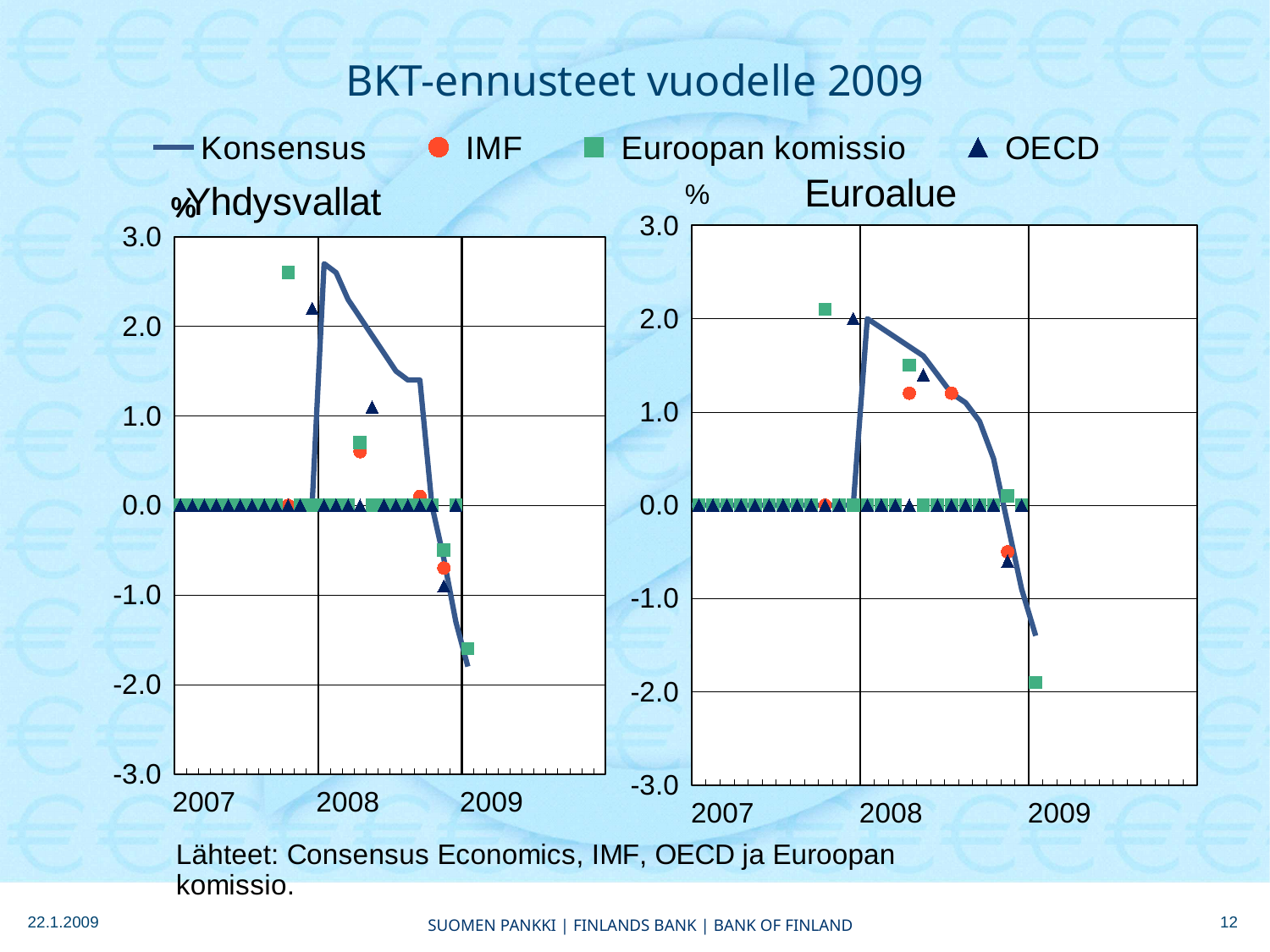
What kind of chart is the Yhdysvallat chart? line chart In the Euroalue chart, is the latest Euroopan komissio point greater or less than -1.0? less What is the title of the slide? BKT-ennusteet vuodelle 2009 How many series does the legend list? 4 In the Euroalue chart, is the final value of the Konsensus line greater or less than -1.0? less Which series is drawn as a line in the charts? Konsensus In the Yhdysvallat chart, is the final value of the Konsensus line greater or less than -1.0? less Is the first Euroopan komissio point higher in the Yhdysvallat chart or in the Euroalue chart? Yhdysvallat In the Euroalue chart, does the Konsensus line rise or fall during 2008? fall How many years are labelled on the x axis of the Euroalue chart? 3